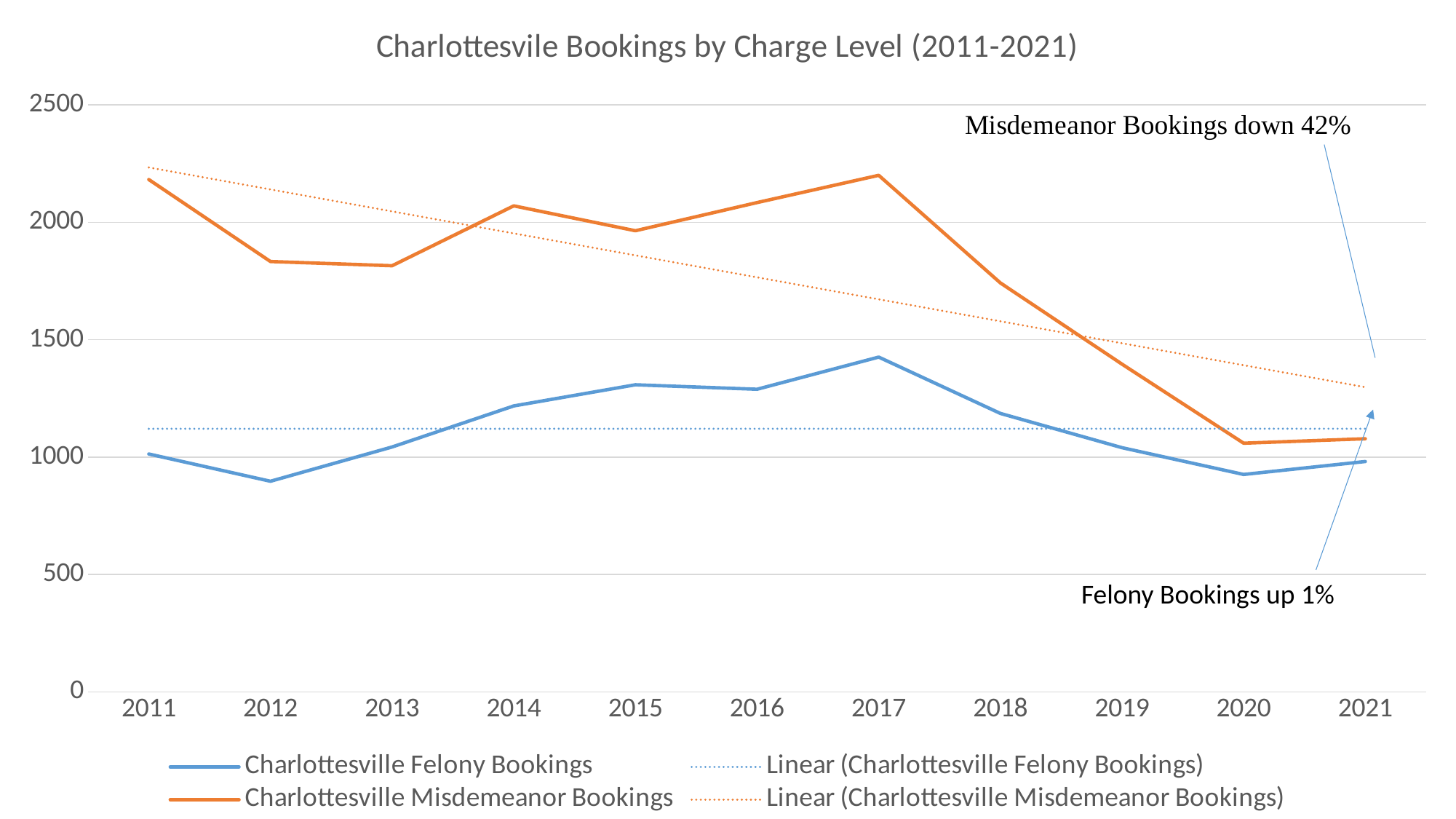
Is the value for Charlottesville Misdemeanor Bookings in 2011 greater or less than 2000? greater How many years are shown on the x axis? 11 What kind of chart is shown on the slide? line chart According to the annotation on the chart, by what percentage are Misdemeanor Bookings down? 42% Do Charlottesville Misdemeanor Bookings generally rise or fall from 2017 to 2020? fall In which year do Charlottesville Felony Bookings reach their highest value? 2017 In 2011, which is larger: Charlottesville Felony Bookings or Charlottesville Misdemeanor Bookings? Charlottesville Misdemeanor Bookings Is the value for Charlottesville Misdemeanor Bookings in 2020 greater or less than 1500? less How many entries does the legend list? 4 Is the value for Charlottesville Felony Bookings in 2017 greater or less than 1000? greater What is the title of the chart? Charlottesvile Bookings by Charge Level (2011-2021)